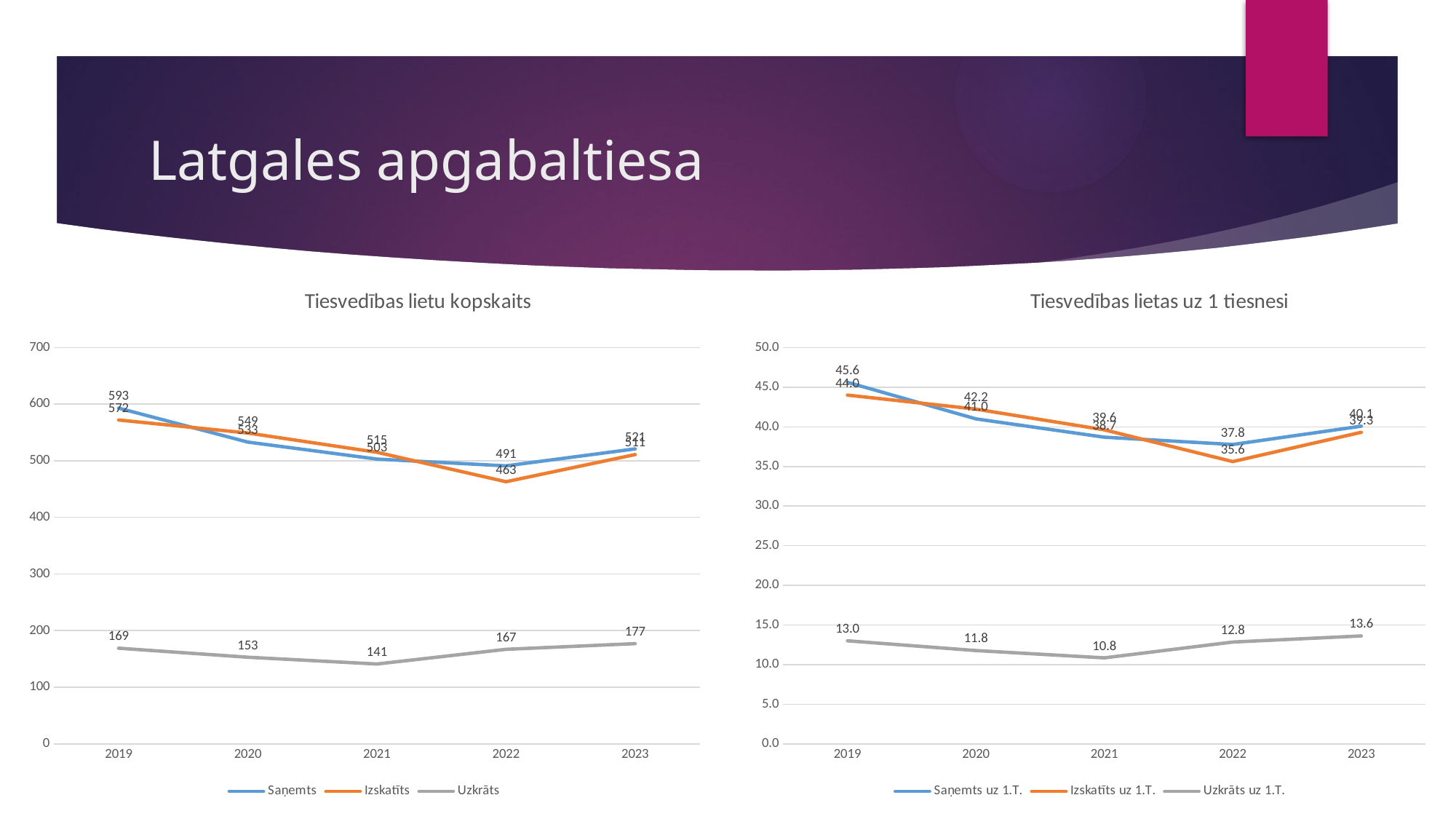
In the chart titled "Tiesvedības lietu kopskaits", in which year is Uzkrāts lowest? 2021 How many series does the legend of the chart titled "Tiesvedības lietas uz 1 tiesnesi" list? 3 In the chart titled "Tiesvedības lietas uz 1 tiesnesi", what is the value of Izskatīts uz 1.T. in 2022? 35.6 In the chart titled "Tiesvedības lietu kopskaits", which is larger in 2022: Saņemts or Izskatīts? Saņemts In the chart titled "Tiesvedības lietu kopskaits", what is the value of Saņemts in 2019? 593 In the chart titled "Tiesvedības lietas uz 1 tiesnesi", what is the value of Uzkrāts uz 1.T. in 2021? 10.8 In the chart titled "Tiesvedības lietu kopskaits", what is the value of Izskatīts in 2022? 463 What kind of chart is the chart titled "Tiesvedības lietu kopskaits"? Line chart In the chart titled "Tiesvedības lietu kopskaits", what is the value of Uzkrāts in 2021? 141 In the chart titled "Tiesvedības lietas uz 1 tiesnesi", in which year is Uzkrāts uz 1.T. highest? 2023 In the chart titled "Tiesvedības lietu kopskaits", what is the difference between Uzkrāts in 2023 and Uzkrāts in 2019? 8 In the chart titled "Tiesvedības lietu kopskaits", in which year is Uzkrāts highest? 2023